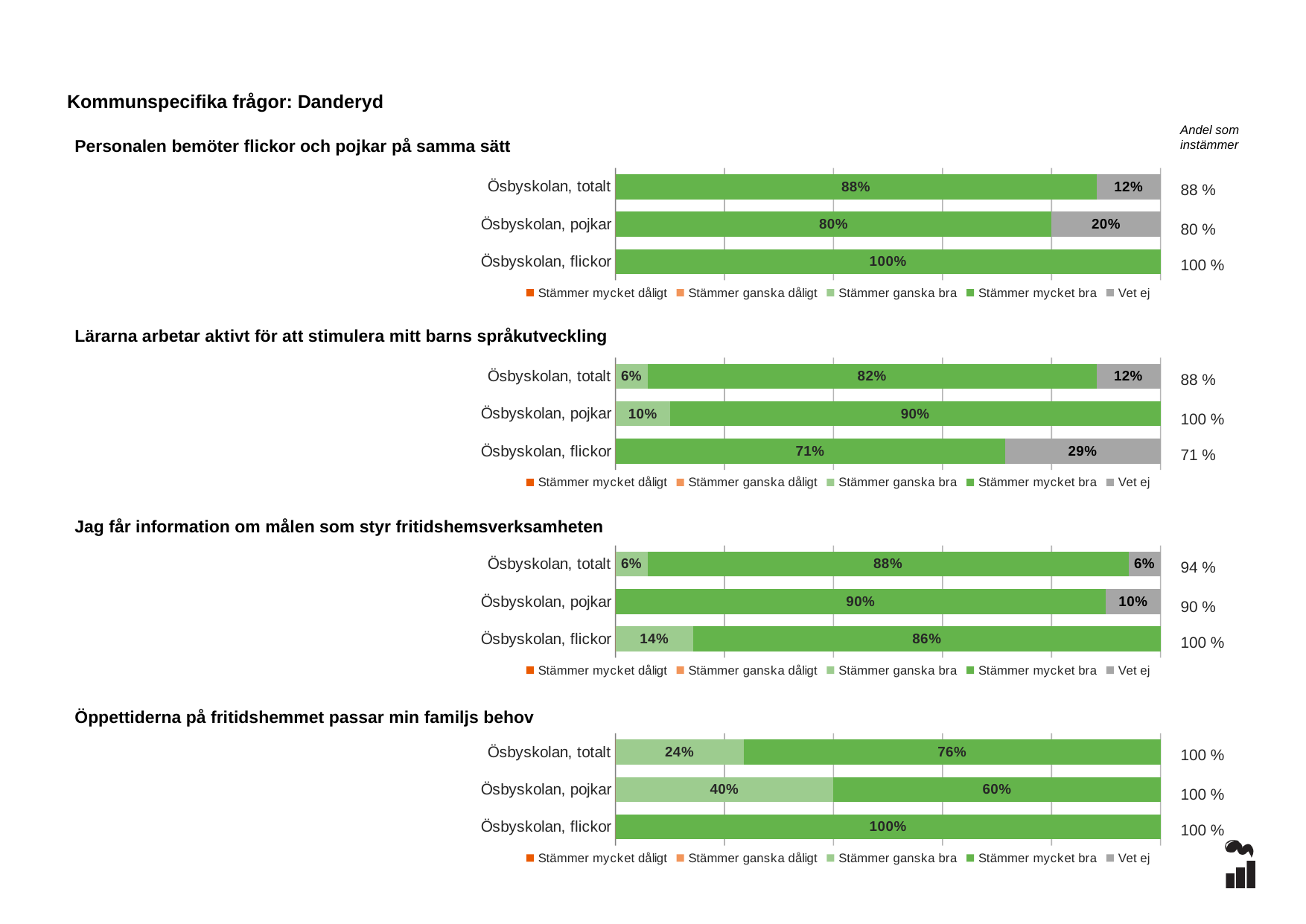
In the chart 'Lärarna arbetar aktivt för att stimulera mitt barns språkutveckling', what is the 'Vet ej' value for Ösbyskolan, flickor? 29% How many series does the legend of the chart 'Personalen bemöter flickor och pojkar på samma sätt' list? 5 In the chart 'Personalen bemöter flickor och pojkar på samma sätt', what is the 'Stämmer mycket bra' value for Ösbyskolan, pojkar? 80% In the chart 'Jag får information om målen som styr fritidshemsverksamheten', which is larger: the 'Stämmer mycket bra' value for Ösbyskolan, pojkar or for Ösbyskolan, flickor? Ösbyskolan, pojkar In the chart 'Öppettiderna på fritidshemmet passar min familjs behov', what is the 'Stämmer ganska bra' value for Ösbyskolan, pojkar? 40% What kind of chart is 'Jag får information om målen som styr fritidshemsverksamheten'? Stacked bar chart In the chart 'Lärarna arbetar aktivt för att stimulera mitt barns språkutveckling', what is the difference between the 'Stämmer mycket bra' values for Ösbyskolan, pojkar and Ösbyskolan, flickor? 19% How many categories are shown in the chart 'Öppettiderna på fritidshemmet passar min familjs behov'? 3 In the chart 'Personalen bemöter flickor och pojkar på samma sätt', what is the 'Vet ej' value for Ösbyskolan, totalt? 12% In the chart 'Jag får information om målen som styr fritidshemsverksamheten', what is the 'Stämmer ganska bra' value for Ösbyskolan, flickor? 14% In the chart 'Lärarna arbetar aktivt för att stimulera mitt barns språkutveckling', which category has the highest 'Stämmer mycket bra' value? Ösbyskolan, pojkar In the chart 'Öppettiderna på fritidshemmet passar min familjs behov', which category has the lowest 'Stämmer mycket bra' value? Ösbyskolan, pojkar